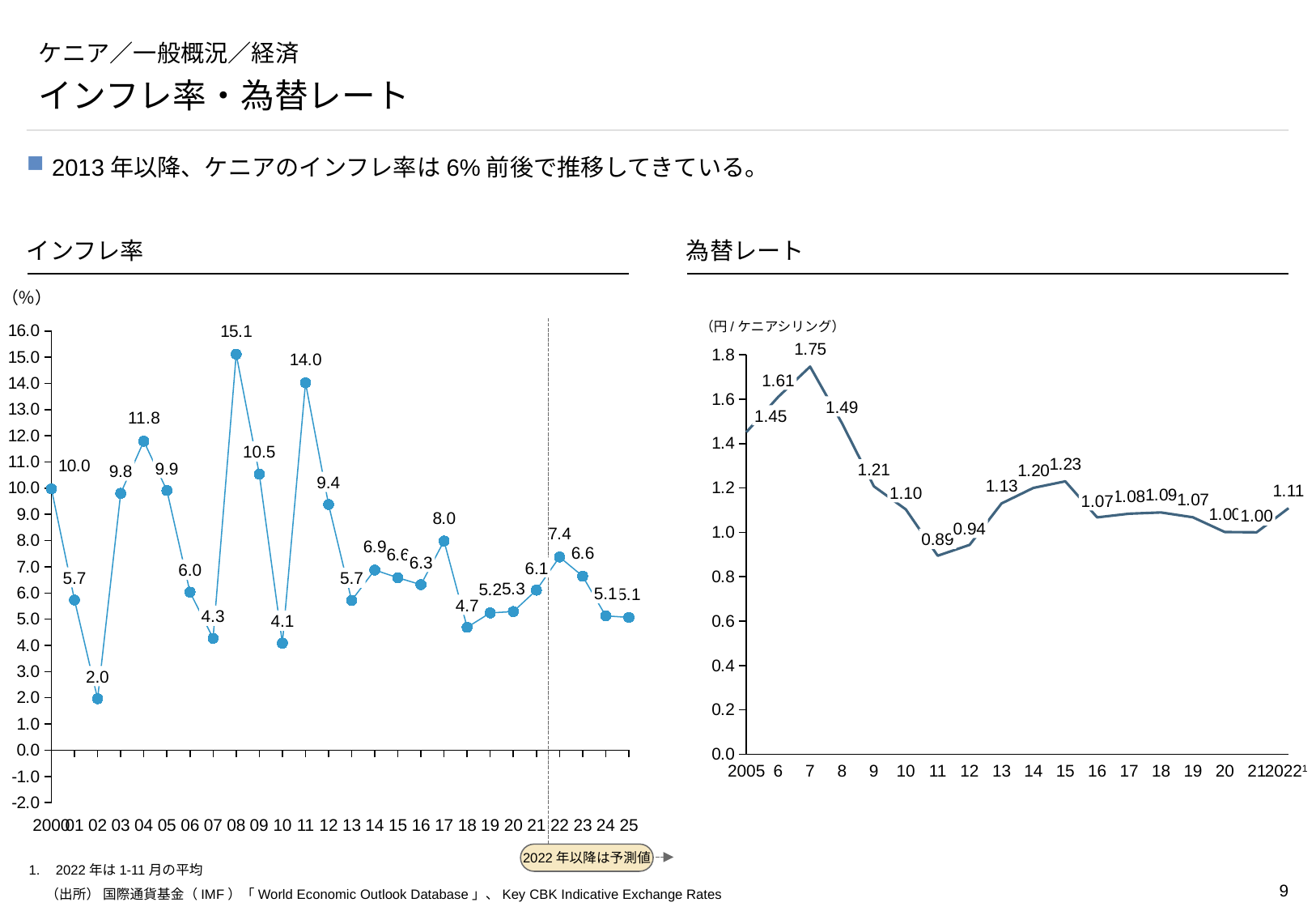
In the インフレ率 chart, what is the difference between the 2011 value and the 2010 value? 9.9 What unit is shown on the 為替レート chart's axis label? 円/ケニアシリング What type of chart is the インフレ率 chart? Line chart In the インフレ率 chart, what is the inflation rate for 2022? 7.4 In the 為替レート chart, do the values rise or fall from 2005 to 2007? Rise In the 為替レート chart, which year has the lowest value? 2011 In the 為替レート chart, what is the difference between the 2007 value and the 2011 value? 0.86 In the インフレ率 chart, which year has the lowest inflation rate? 2002 In the 為替レート chart, what is the value for 2007? 1.75 In the インフレ率 chart, what is the inflation rate for 2008? 15.1 In the インフレ率 chart, which is larger, the value for 2017 or the value for 2018? 2017 In the インフレ率 chart, which year has the highest inflation rate? 2008